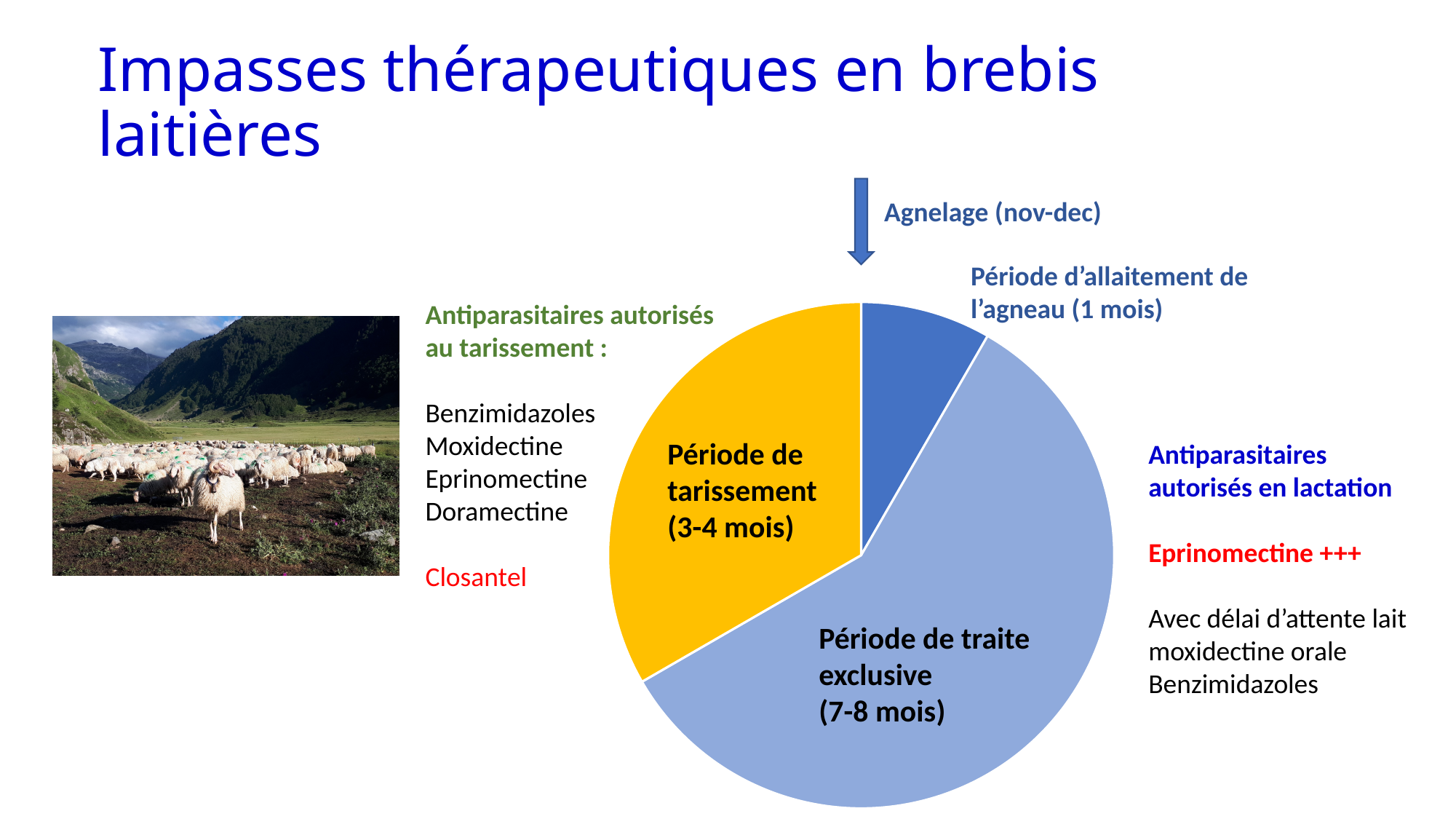
What colour is the Période de tarissement slice of the pie chart? yellow What kind of chart is shown on the slide? pie chart What duration is given on the slide for the Période de traite exclusive slice? 7-8 mois Which slice of the pie chart is the smallest? Période d'allaitement de l'agneau (1 mois) Which slice is larger: Période de traite exclusive or Période de tarissement? Période de traite exclusive What duration is given on the slide for the Période de tarissement slice? 3-4 mois What duration is given on the slide for the Période d'allaitement de l'agneau slice? 1 mois Which slice is larger: Période de tarissement or Période d'allaitement de l'agneau? Période de tarissement Which slice of the pie chart is the largest? Période de traite exclusive (7-8 mois) How many slices does the pie chart have? 3 What colour is the Période de traite exclusive slice of the pie chart? light blue